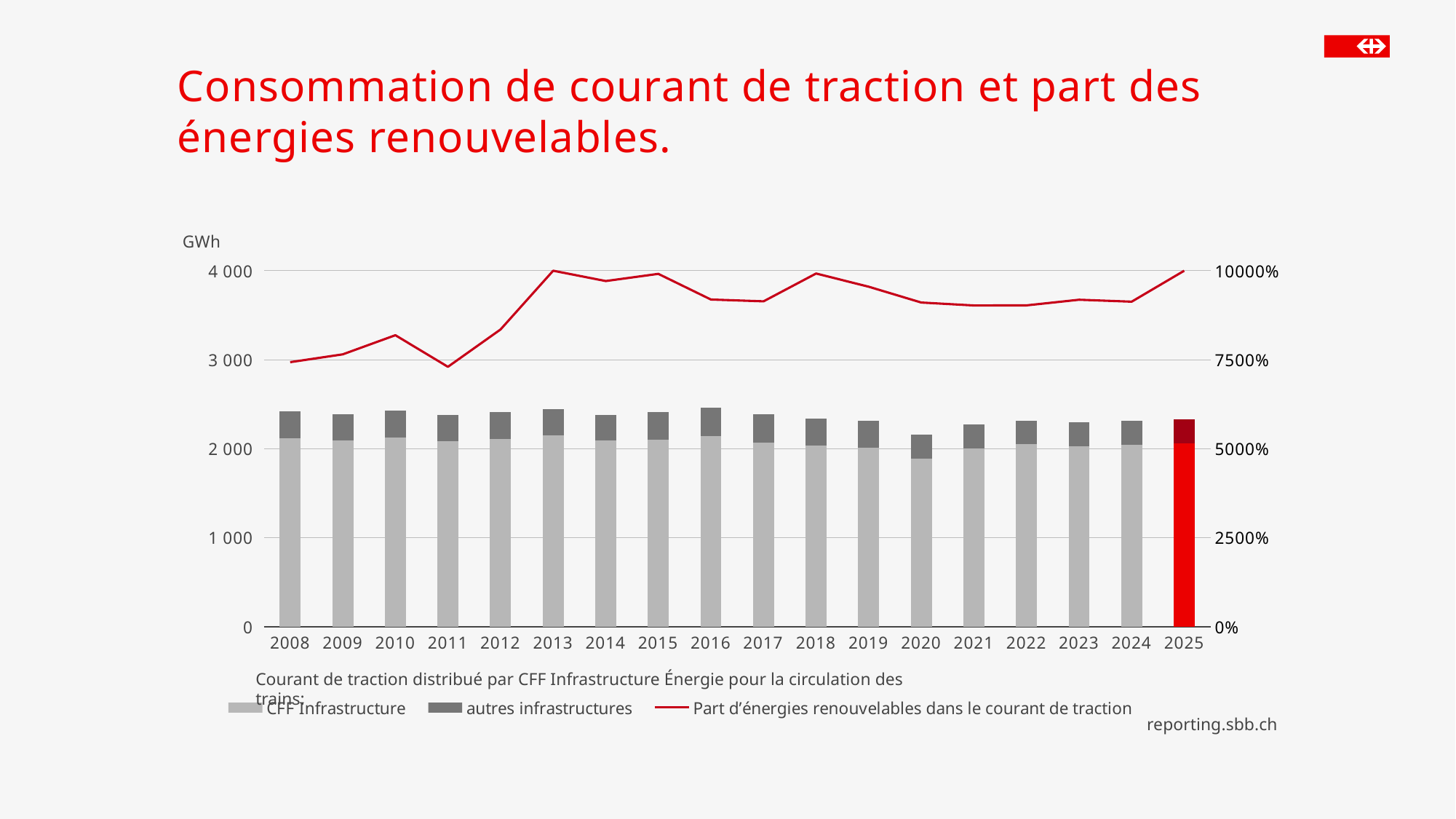
Which year has the lowest value for the line 'Part d'énergies renouvelables dans le courant de traction'? 2011 What unit is shown on the left vertical axis of the chart? GWh Which year has the lowest total stacked bar (CFF Infrastructure plus autres infrastructures)? 2020 How many series does the chart legend list? 3 How many years are shown on the x axis of the chart? 18 Does the 'Part d'énergies renouvelables' line rise or fall between 2011 and 2013? rise Is the value of the 'Part d'énergies renouvelables' line for 2016 greater or less than 7500%? greater Is the CFF Infrastructure bar segment for 2020 greater or less than 2 000 GWh? less Is the CFF Infrastructure bar segment for 2008 greater or less than 2 000 GWh? greater What kind of chart is shown on the slide? Stacked bar chart combined with a line chart Which is larger, the 'Part d'énergies renouvelables' line value for 2011 or for 2013? 2013